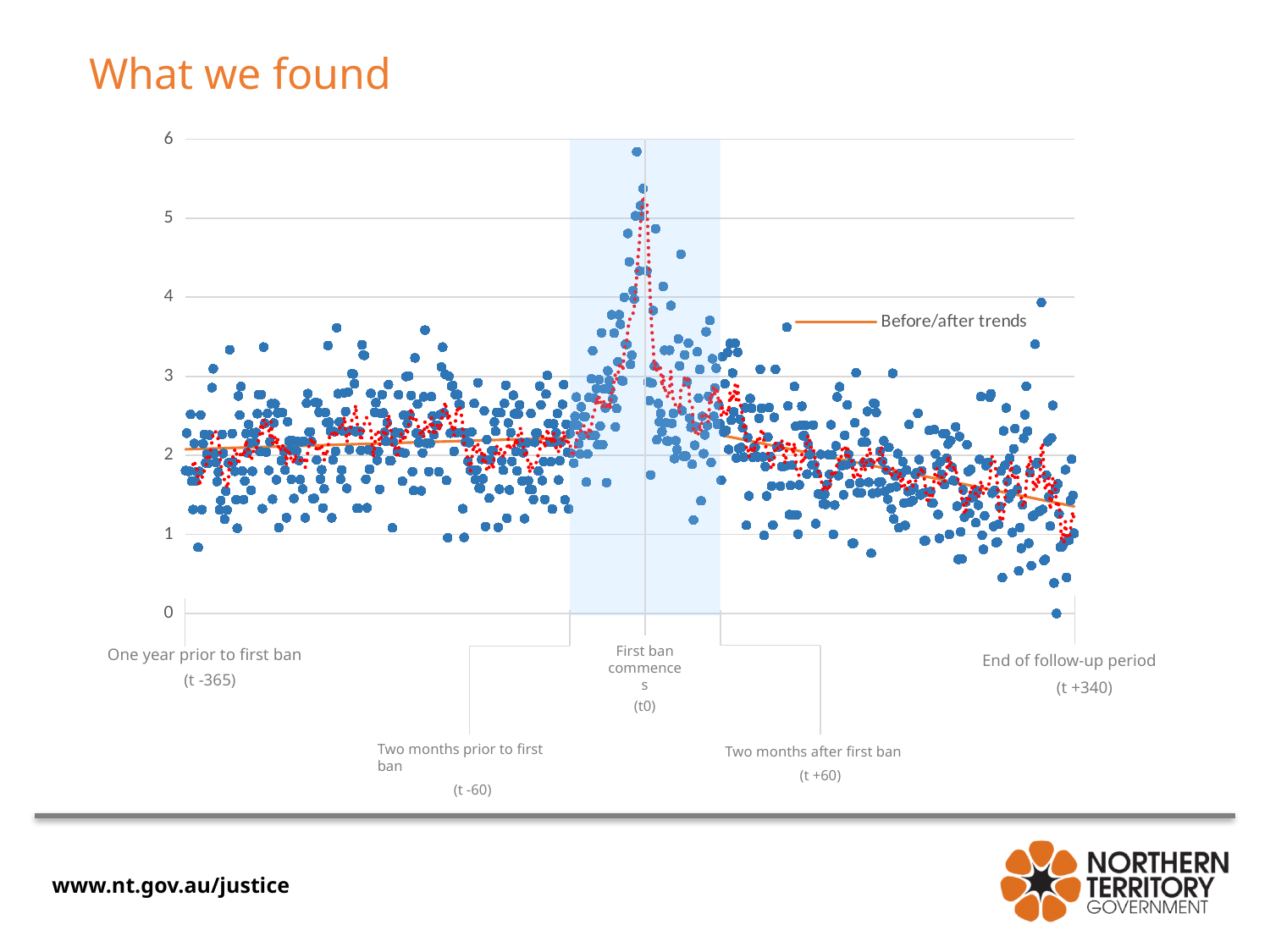
What kind of chart is shown on the slide? scatter chart What time offset is given for one year prior to the first ban? t -365 Is the trend line value at one year prior to the first ban greater or less than 1? greater What time offset is given for the end of the follow-up period? t +340 What is the only entry shown in the chart legend? Before/after trends After the first ban commences, do the plotted values generally rise or fall towards the end of the follow-up period? fall How many series does the chart legend list? 1 What time offset is given for two months prior to the first ban? t -60 Is the highest plotted point, near the first ban commencing, greater or less than 5? greater How many labelled time points are marked along the horizontal axis? 5 What is the highest value shown on the vertical axis? 6 Is the trend line value at the end of the follow-up period greater or less than 2? less